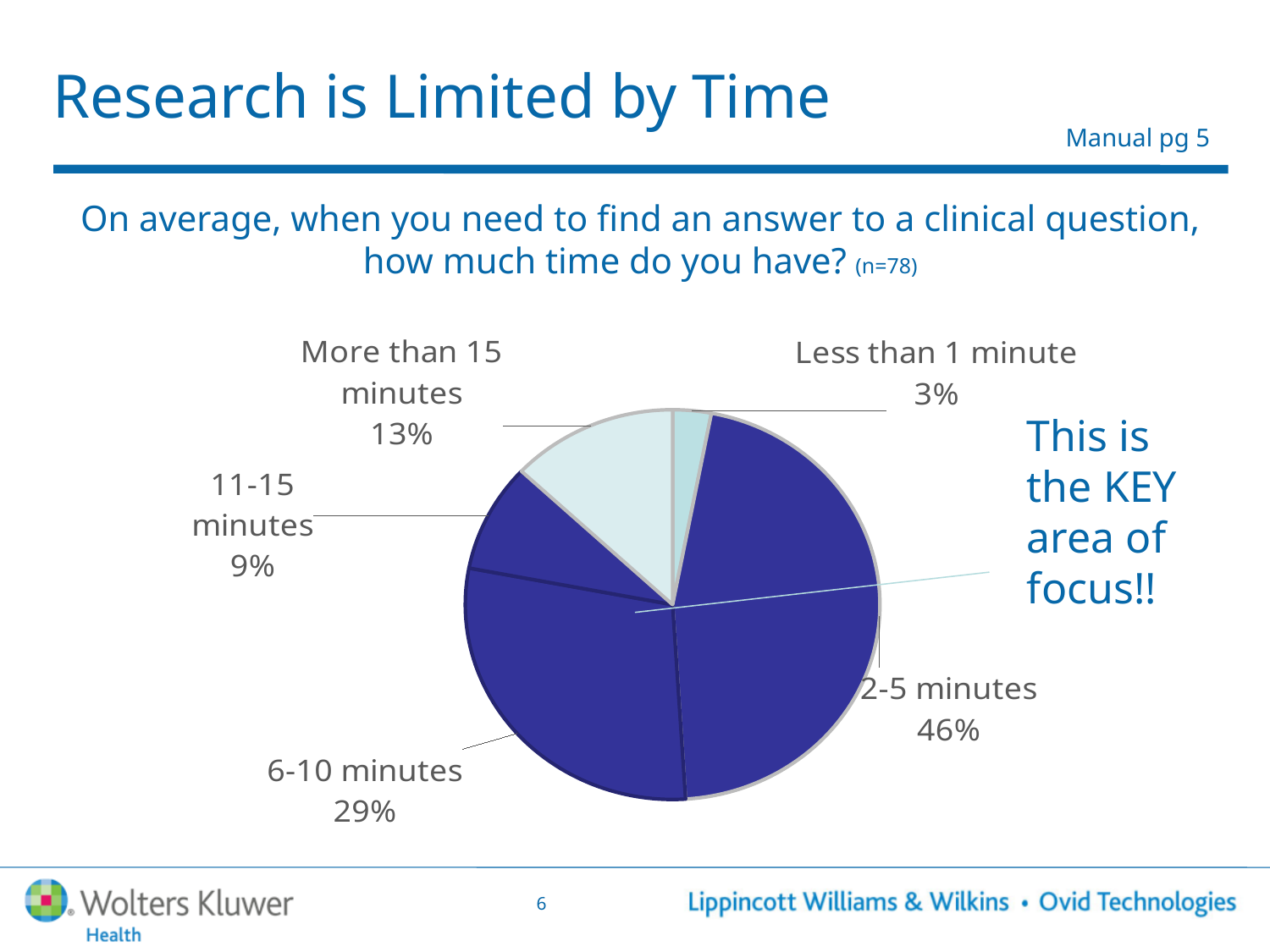
What kind of chart is shown on the slide? pie chart What share of respondents said they have 6-10 minutes? 29% What share of respondents said they have less than 1 minute? 3% How many slices does the pie chart have? 5 Which time category has the largest share of the pie? 2-5 minutes What share of respondents said they have 2-5 minutes? 46% Which slice is larger: 11-15 minutes or More than 15 minutes? More than 15 minutes What is the difference in percentage points between the 2-5 minutes slice and the 6-10 minutes slice? 17 What share of respondents said they have more than 15 minutes? 13% What is the sample size (n) stated in the chart's question text? n=78 What share of respondents said they have 11-15 minutes? 9% Which time category has the smallest share of the pie? Less than 1 minute